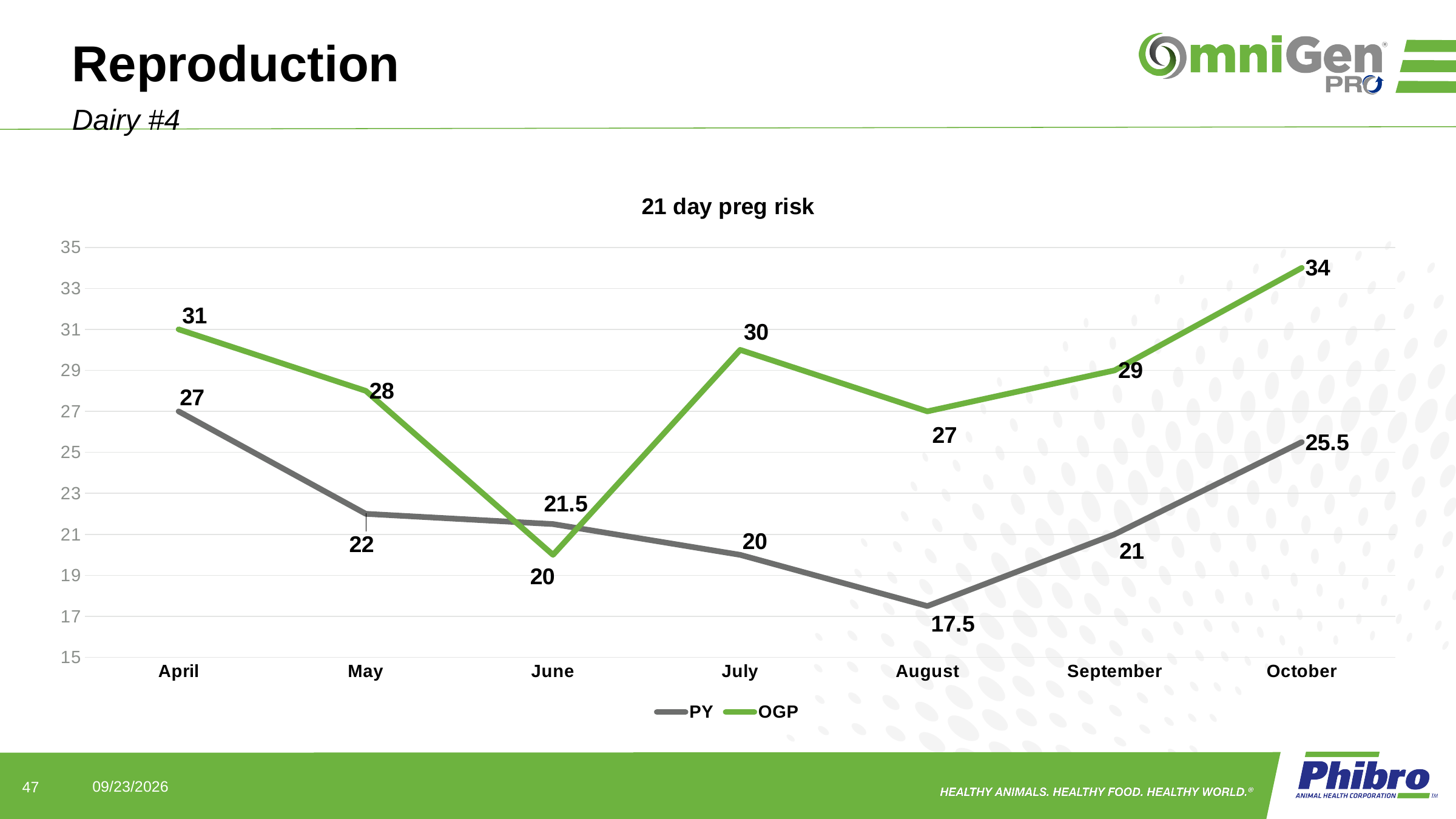
How many months are plotted along the x axis? 7 In which month is the PY value highest? April What is the OGP value for October? 34 What type of chart is shown on the slide? line chart In which month is the OGP value lowest? June What is the title of the chart? 21 day preg risk What is the PY value for June? 21.5 Which series has the larger value in June, PY or OGP? PY What is the difference between the OGP and PY values in July? 10 Does the PY line rise or fall from April to August? fall What is the PY value for August? 17.5 How many series does the legend list? 2